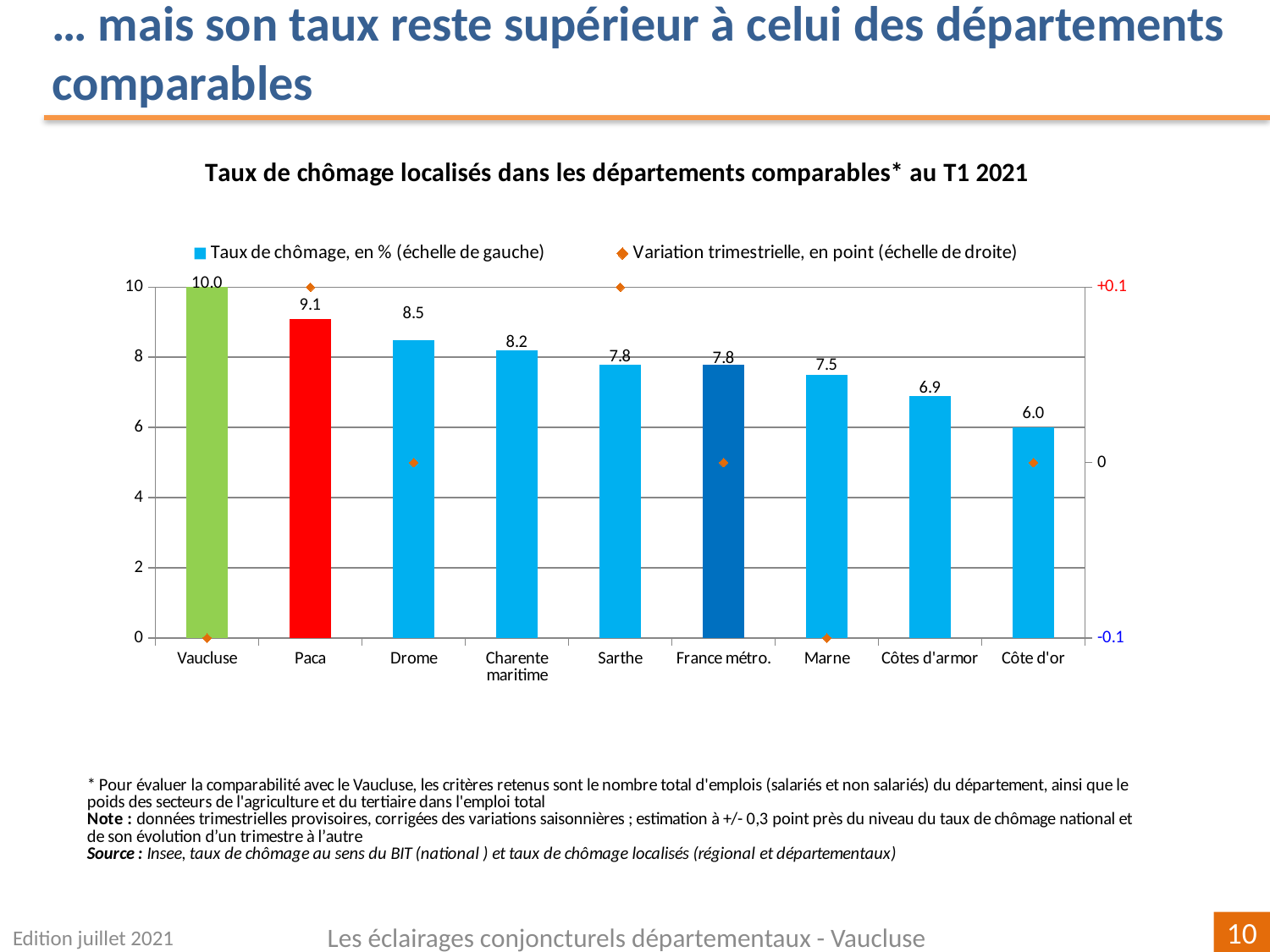
What is the unemployment rate (taux de chômage) shown for Vaucluse? 10.0 Which category has the lowest unemployment rate? Côte d'or How many series does the legend list? 2 What is the unemployment rate shown for Côtes d'armor? 6.9 What kind of chart is used to show the unemployment rates? Bar chart What is the difference between the unemployment rate of Vaucluse and that of Paca? 0.9 Which has a higher unemployment rate, Drome or Marne? Drome Do the unemployment rate bars rise or fall from left to right along the x axis? Fall Which category has the highest unemployment rate? Vaucluse What is the unemployment rate shown for Charente maritime? 8.2 What is the quarterly variation (variation trimestrielle) shown for Paca on the right-hand axis? +0.1 How many categories (departments/areas) are shown on the x axis? 9